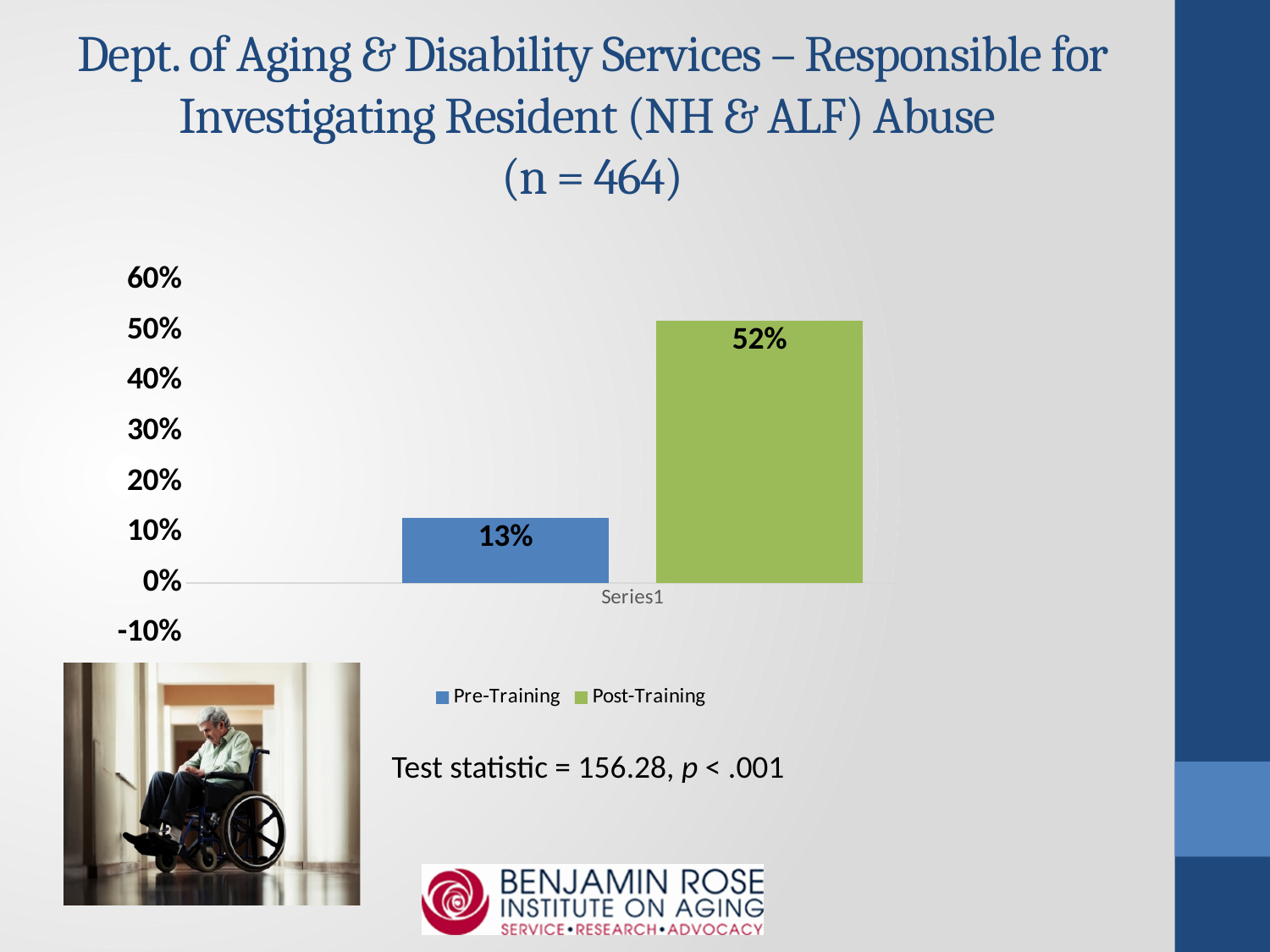
What is the difference between the Post-Training and Pre-Training values? 39% Is the Post-Training value greater or less than 50%? greater Which series has the lowest value on the chart? Pre-Training What colour is the Post-Training bar? Green What is the Post-Training value shown on the chart? 52% Is the Pre-Training value greater or less than 20%? less What is the sample size (n) given in the slide title? 464 How many series does the legend list? 2 What kind of chart is shown on the slide? Bar chart How many bars are plotted on the chart? 2 What is the Pre-Training value shown on the chart? 13% Which series has the higher value, Pre-Training or Post-Training? Post-Training